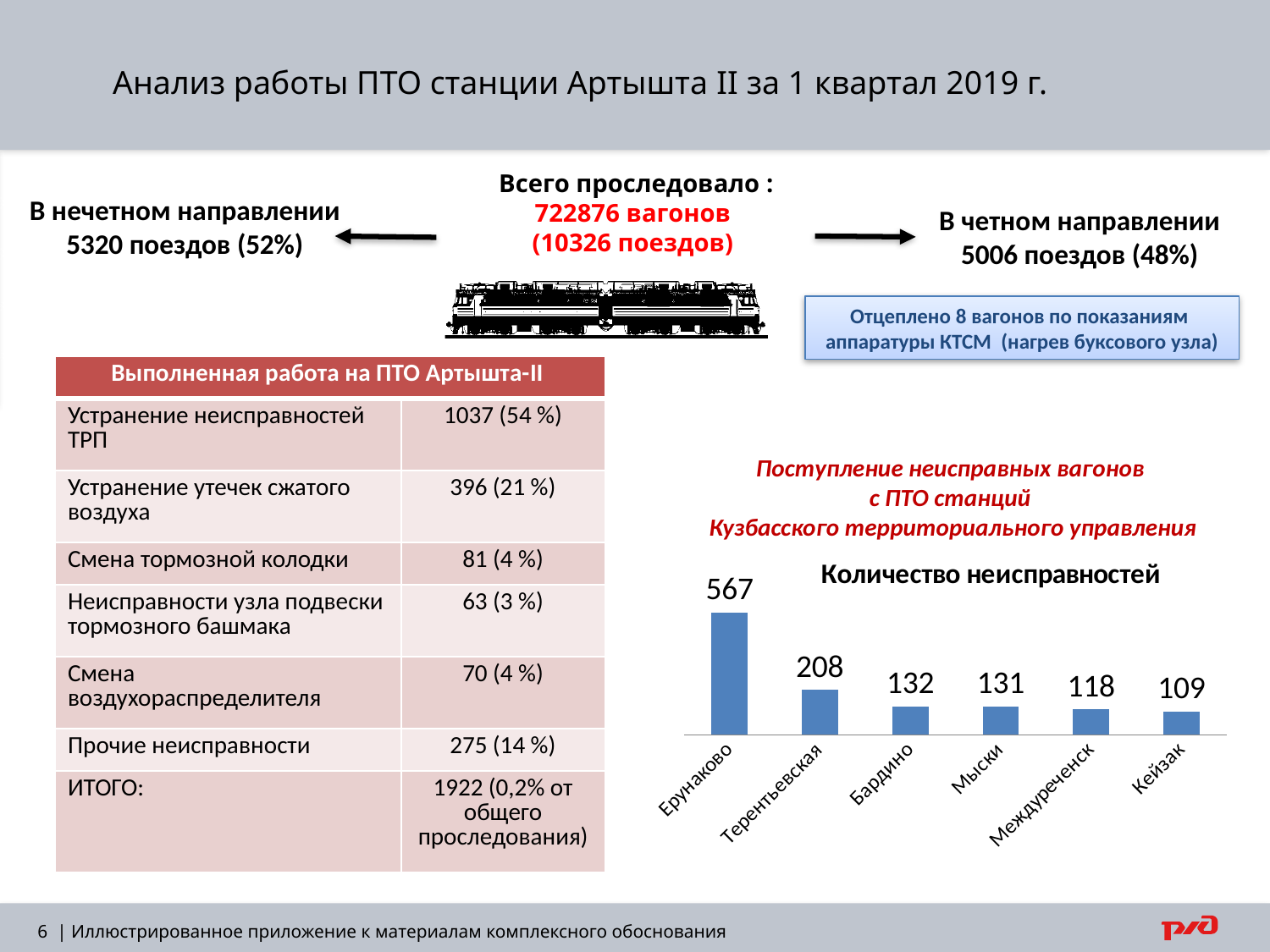
How many stations are shown in the chart 'Количество неисправностей'? 6 Which station has the lowest value in the chart 'Количество неисправностей'? Кейзак What is the value for Ерунаково in the chart 'Количество неисправностей'? 567 In the chart 'Количество неисправностей', which is larger: the value for Терентьевская or the value for Мыски? Терентьевская What is the value for Терентьевская in the chart 'Количество неисправностей'? 208 What is the value for Кейзак in the chart 'Количество неисправностей'? 109 Do the values in the chart 'Количество неисправностей' rise or fall from left to right? Fall What is the value for Междуреченск in the chart 'Количество неисправностей'? 118 What is the difference between the values for Бардино and Кейзак in the chart 'Количество неисправностей'? 23 Which station has the highest value in the chart 'Количество неисправностей'? Ерунаково What is the difference between the values for Ерунаково and Терентьевская in the chart 'Количество неисправностей'? 359 What kind of chart is 'Количество неисправностей'? Bar chart